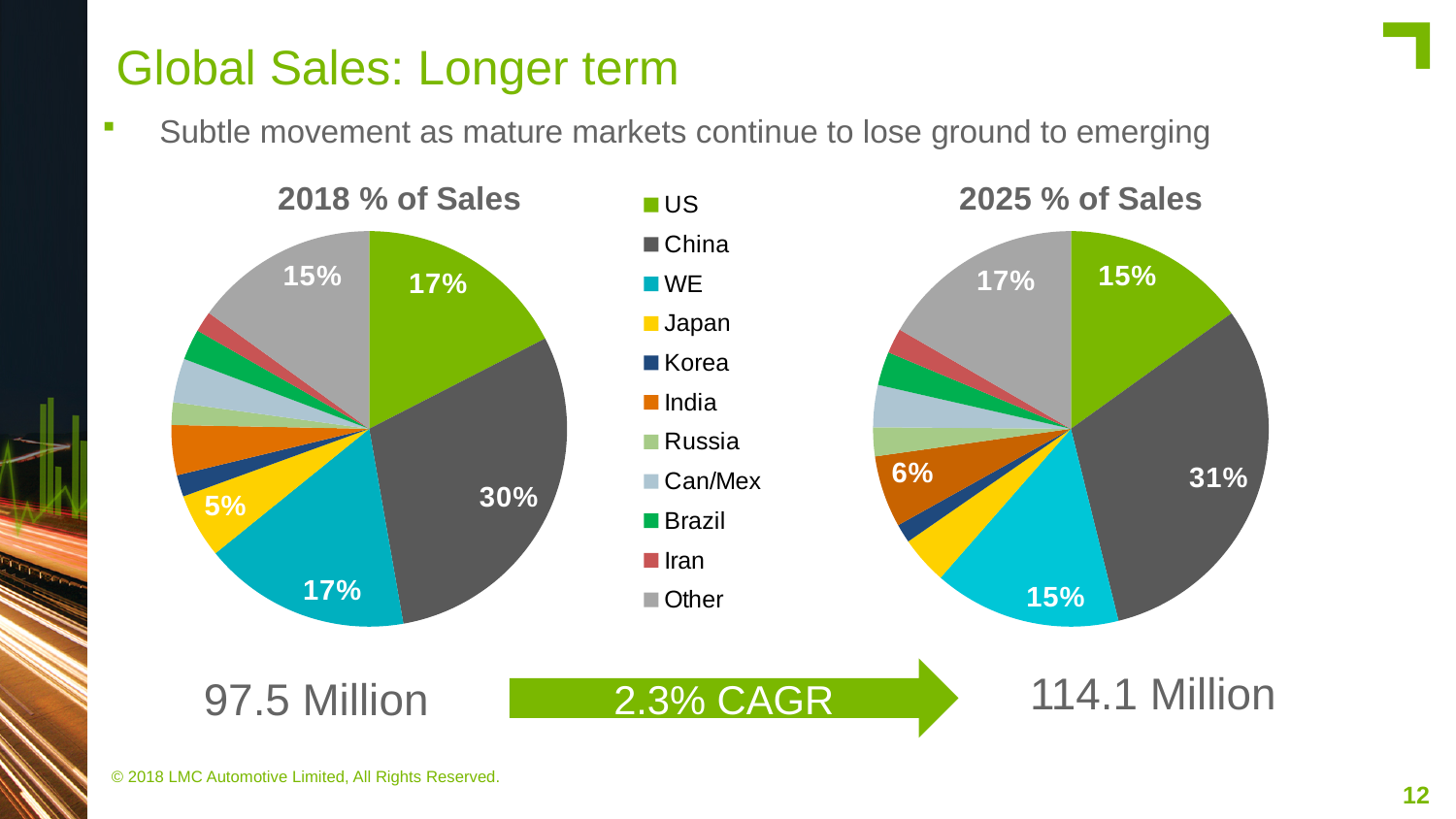
In the 2025 % of Sales pie chart, which category has the largest slice? China In the 2025 % of Sales pie chart, what share does India have? 6% How many categories does the legend shared by the two pie charts list? 11 What type of chart is used for the 2018 % of Sales and 2025 % of Sales visuals? Pie chart What is the difference between China's share in the 2025 % of Sales chart and its share in the 2018 % of Sales chart? 1% In the 2018 % of Sales pie chart, what is the share for the US? 17% In the 2025 % of Sales pie chart, what share of sales does China have? 31% In the 2018 % of Sales pie chart, which category has the largest slice? China In the 2025 % of Sales pie chart, what is the share for WE? 15% Is the US share larger in the 2018 % of Sales chart or the 2025 % of Sales chart? 2018 % of Sales In the 2018 % of Sales pie chart, what share of sales does China have? 30% In the 2018 % of Sales pie chart, what share does Japan have? 5%